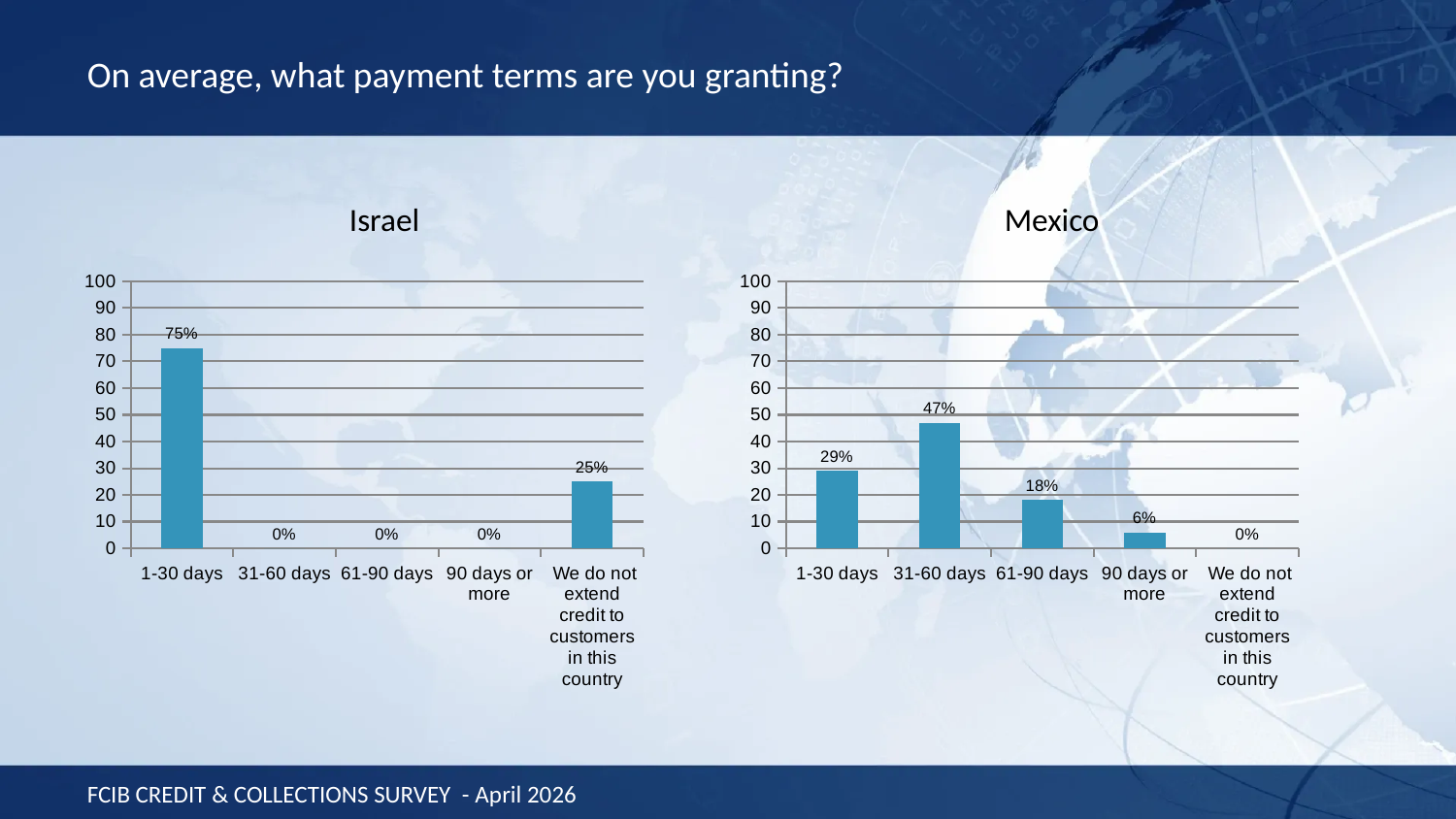
What is the title of the chart on the left side of the slide? Israel In the Mexico chart, what is the value for 90 days or more? 6% In the Israel chart, what is the difference between the values for 1-30 days and 'We do not extend credit to customers in this country'? 50% In the Mexico chart, what is the value for 31-60 days? 47% In the Israel chart, which category has the highest value? 1-30 days In the Mexico chart, what is the difference between the values for 31-60 days and 1-30 days? 18% What kind of chart is the Mexico chart? bar chart Which is larger in the Mexico chart: the value for 61-90 days or the value for 90 days or more? 61-90 days In the Mexico chart, which category has the lowest value? We do not extend credit to customers in this country How many categories are shown on the x axis of the Israel chart? 5 In the Mexico chart, is the value for 1-30 days greater or less than 20? greater In the Israel chart, what is the value for 1-30 days? 75%